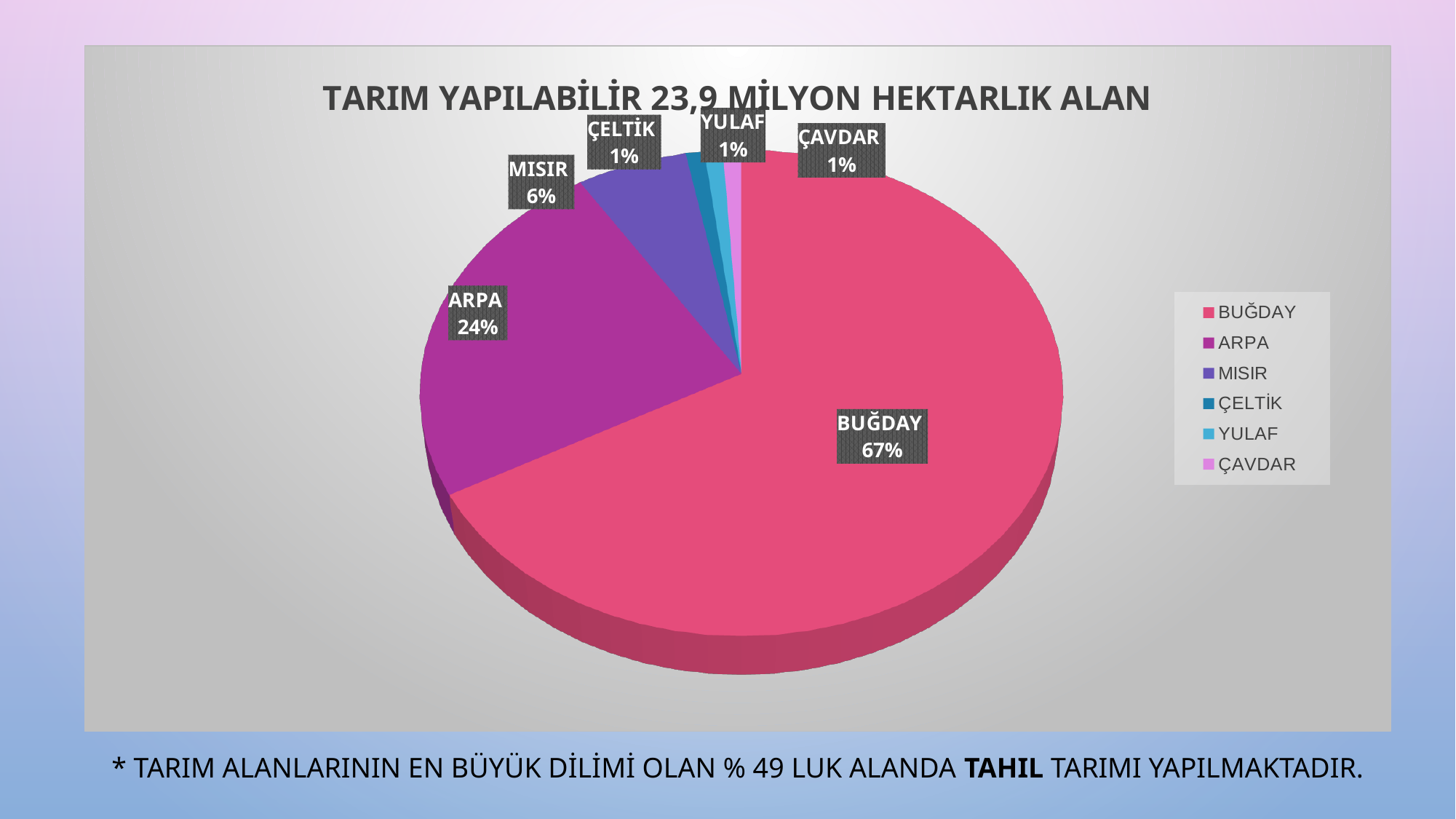
What is the combined share of BUĞDAY and ARPA? 91% How many categories does the legend list? 6 What kind of chart is shown on the slide? pie chart Which is larger, the share of ARPA or the share of MISIR? ARPA Which category is listed last in the legend? ÇAVDAR What share of the pie does MISIR have? 6% Which category has the largest slice of the pie? BUĞDAY What is the difference between the shares of BUĞDAY and ARPA? 43% What share of the pie does ARPA have? 24% What share of the pie does BUĞDAY have? 67% What is the title of the chart? TARIM YAPILABİLİR 23,9 MİLYON HEKTARLIK ALAN